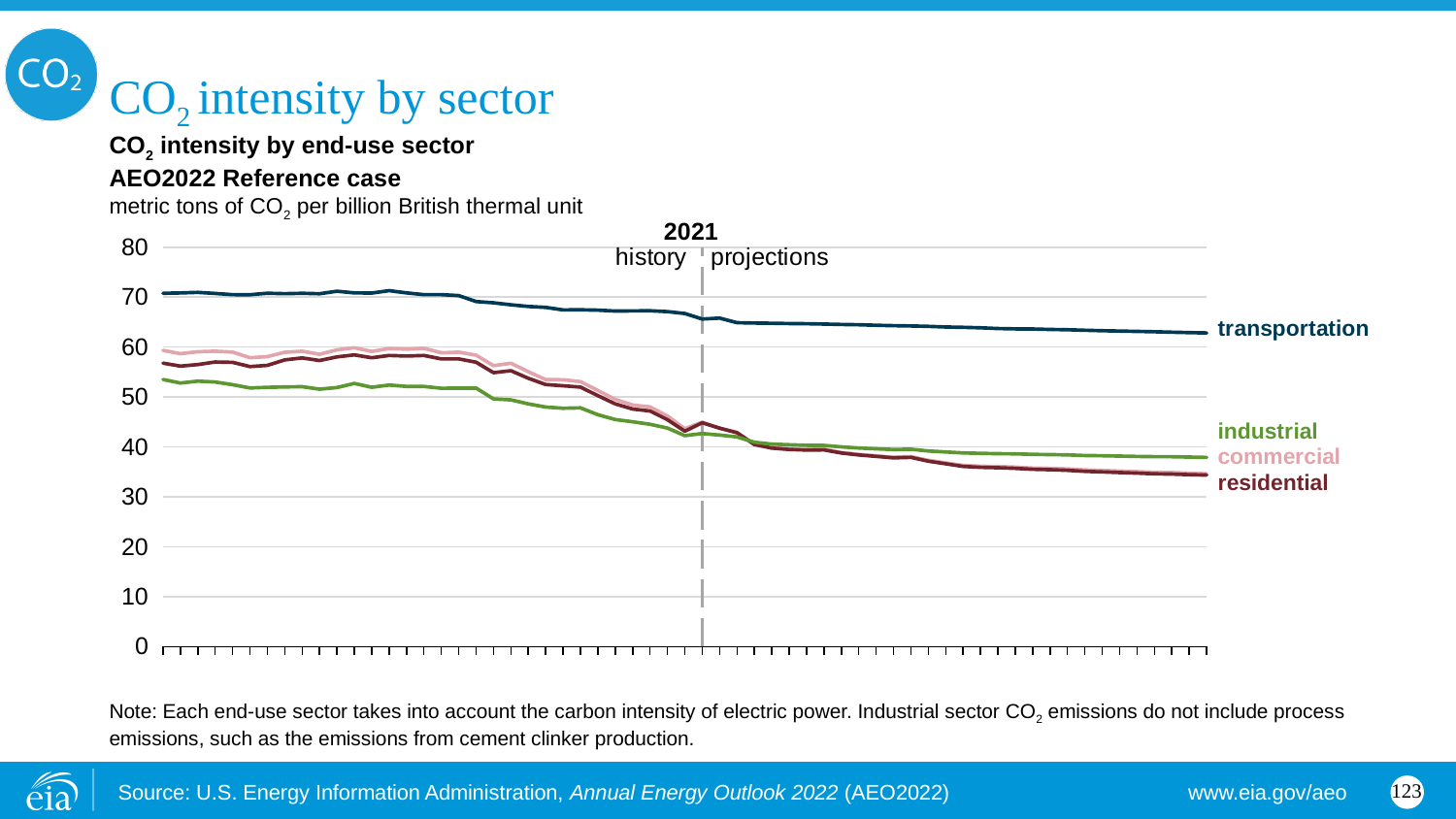
Which sector has the lowest CO2 intensity at the end of the projection period? residential What kind of chart is shown on the slide? line chart Does the CO2 intensity for industrial rise or fall over the period shown? fall Is the value for industrial at the start of the chart greater or less than 50? greater Which is larger at the end of the projection period, the value for industrial or the value for residential? industrial Which sector has the highest CO2 intensity throughout the chart? transportation How many sectors are plotted as lines on the chart? 4 Is the value for transportation at the end of the projection period greater or less than 60? greater Does the CO2 intensity for transportation rise or fall over the period shown? fall What year does the dashed vertical line separating history from projections mark? 2021 What unit is the CO2 intensity measured in on the chart? metric tons of CO2 per billion British thermal unit Is the value for residential at the end of the projection period greater or less than 40? less